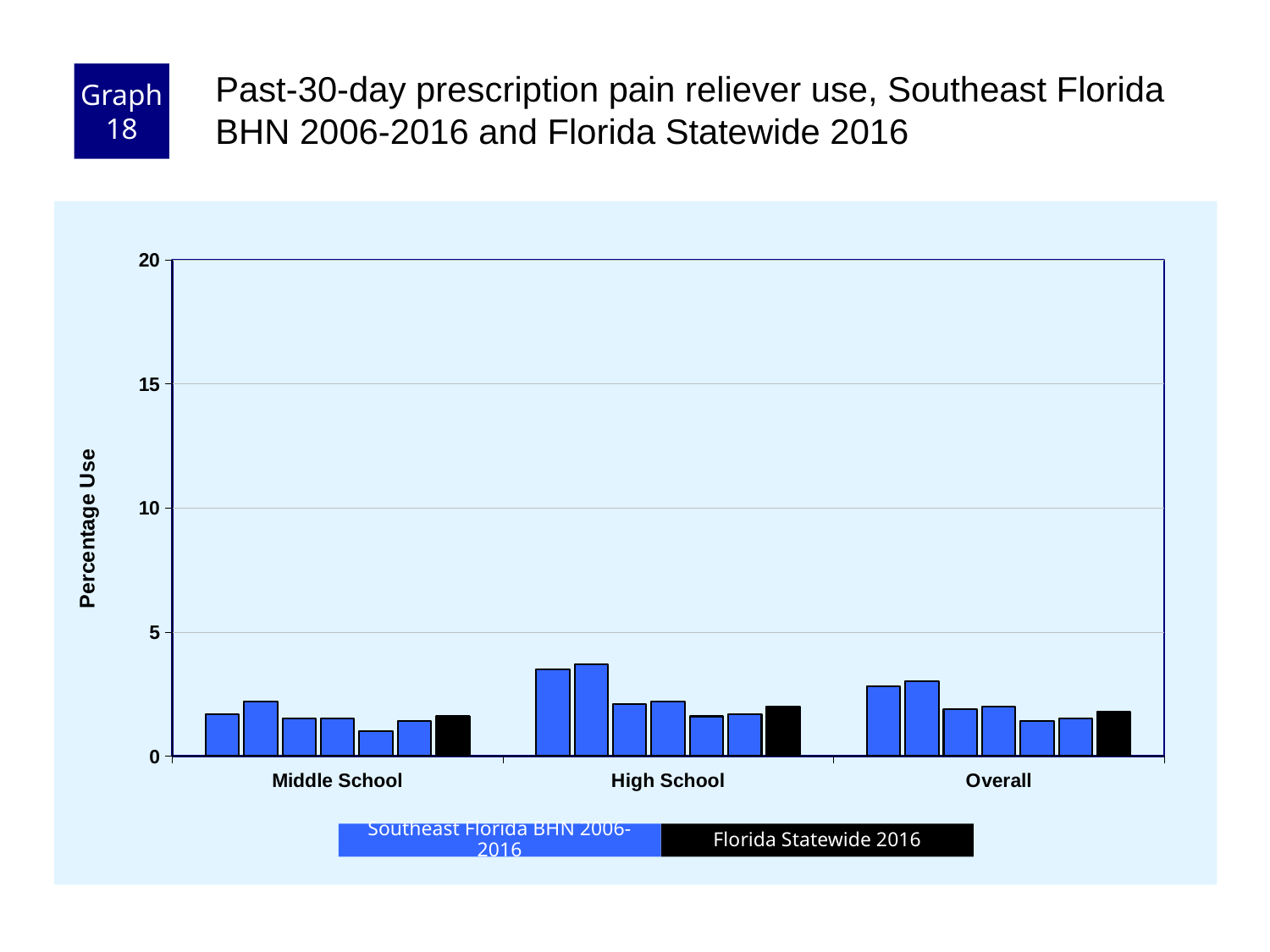
Which category group contains the tallest bar on the chart? High School What colour are the Florida Statewide 2016 bars? black Is the tallest bar in the Overall group greater or less than 5? less What kind of chart is shown on the slide? bar chart What is the highest value shown on the y axis? 20 Is the Florida Statewide 2016 value for Middle School greater or less than 5? less How many school-level categories are shown on the x axis? 3 Which is larger: the Florida Statewide 2016 value for High School or the Florida Statewide 2016 value for Middle School? High School Is the Florida Statewide 2016 value for High School greater or less than 5? less In the High School group, is the tallest Southeast Florida BHN bar larger or smaller than the Florida Statewide 2016 bar? larger What is the label on the y axis? Percentage Use How many series does the legend list? 2